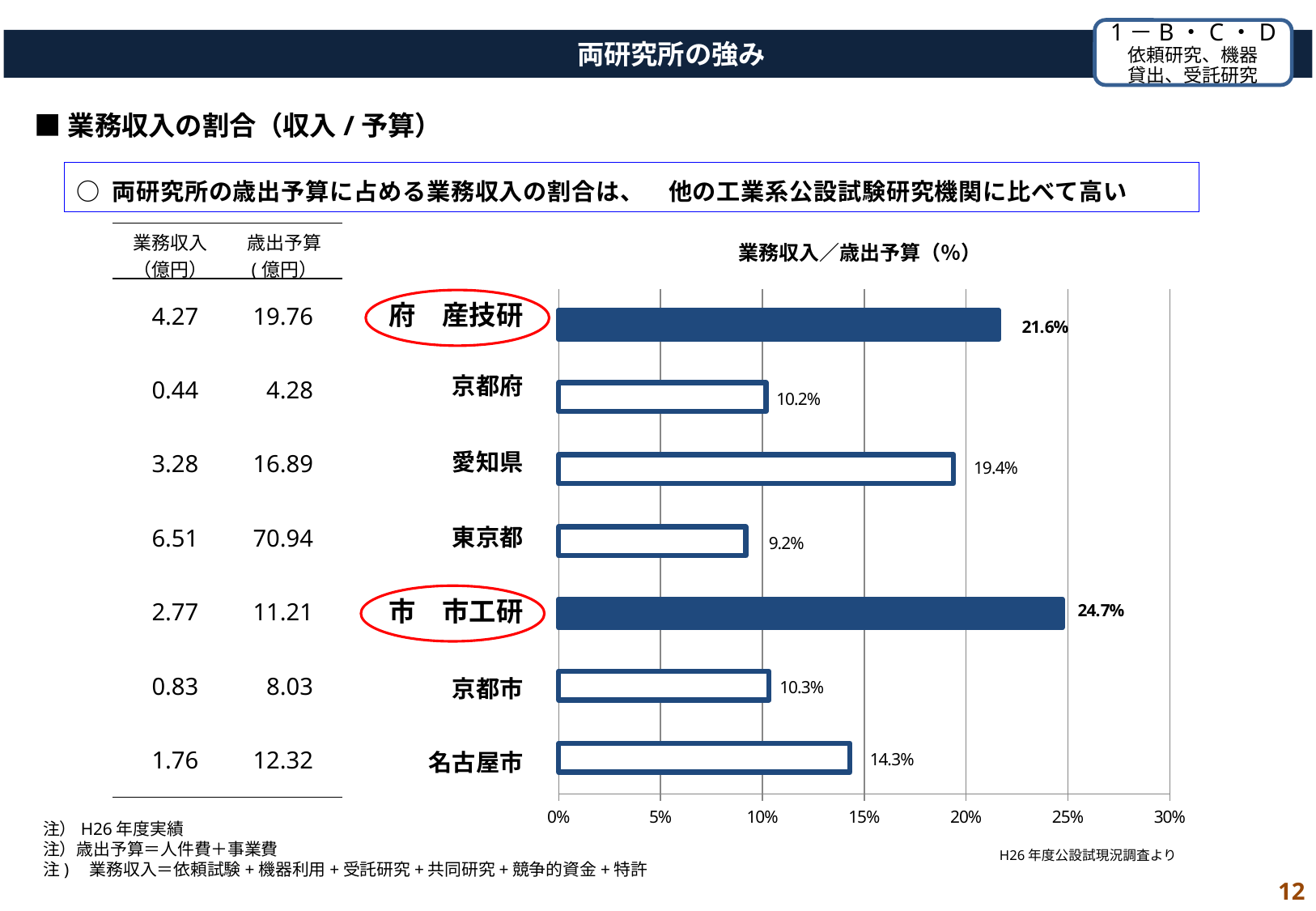
What is the value for 府 産技研? 21.6% How many categories are shown in the chart? 7 What is the title of the chart? 業務収入／歳出予算（%） Which is larger, the value for 愛知県 or the value for 名古屋市? 愛知県 What is the value for 愛知県? 19.4% What is the difference between the values for 市 市工研 and 府 産技研? 3.1% What is the value for 名古屋市? 14.3% What kind of chart is shown on the slide? bar chart Which category has the lowest value? 東京都 Which category has the highest value? 市 市工研 Is the value for 東京都 greater or less than 10%? less What is the value for 市 市工研? 24.7%